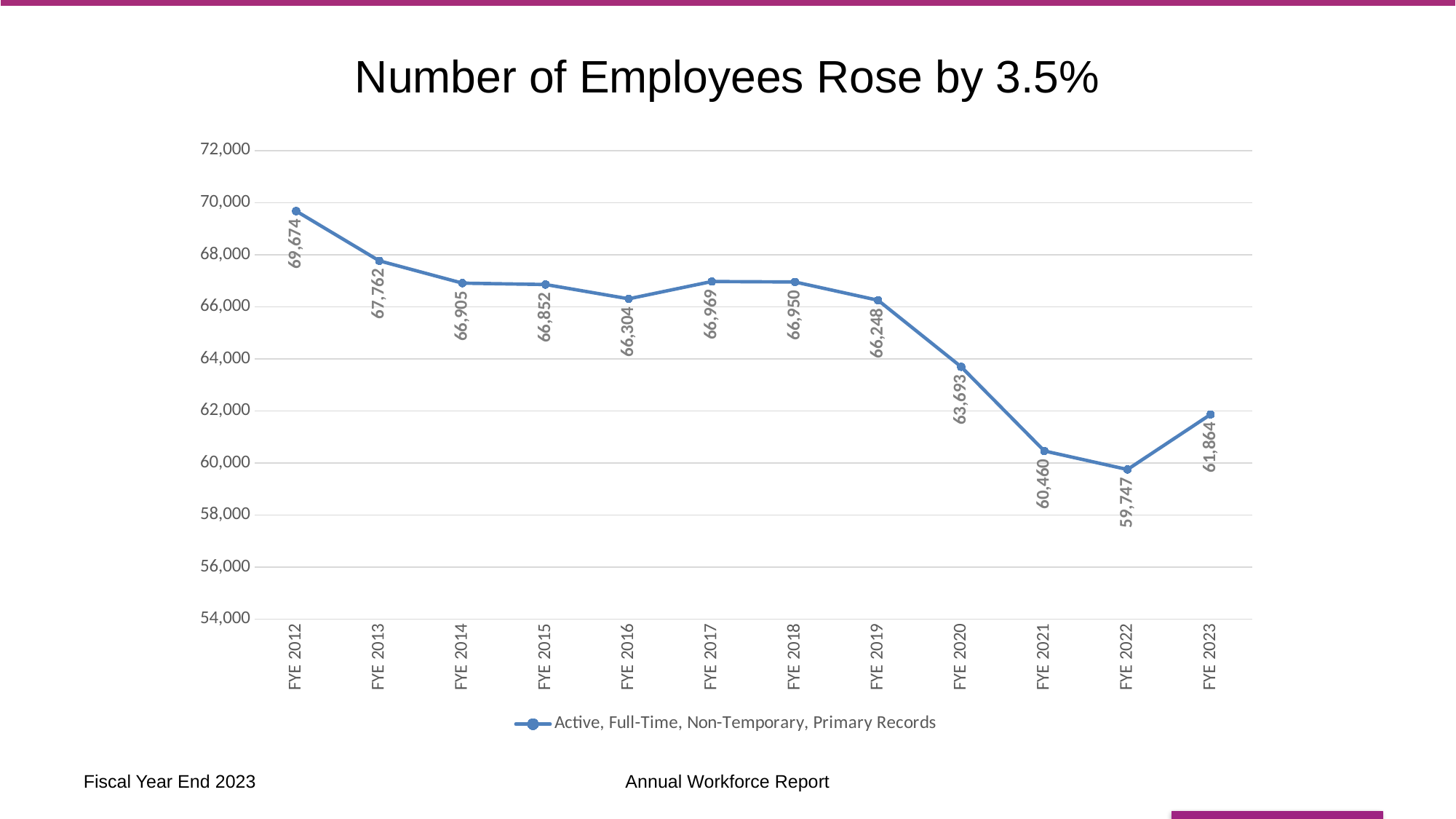
Which is larger, the value for FYE 2017 or the value for FYE 2016? FYE 2017 What is the series name shown in the legend? Active, Full-Time, Non-Temporary, Primary Records Which fiscal year has the lowest value? FYE 2022 What is the value for FYE 2023? 61,864 How many fiscal years are plotted on the chart? 12 What is the value for FYE 2012? 69,674 Is the value for FYE 2021 greater or less than 62,000? less Which fiscal year has the highest value? FYE 2012 What is the difference between the values for FYE 2012 and FYE 2013? 1,912 What is the value for FYE 2020? 63,693 What is the difference between the values for FYE 2023 and FYE 2022? 2,117 What kind of chart is shown on the slide? line chart